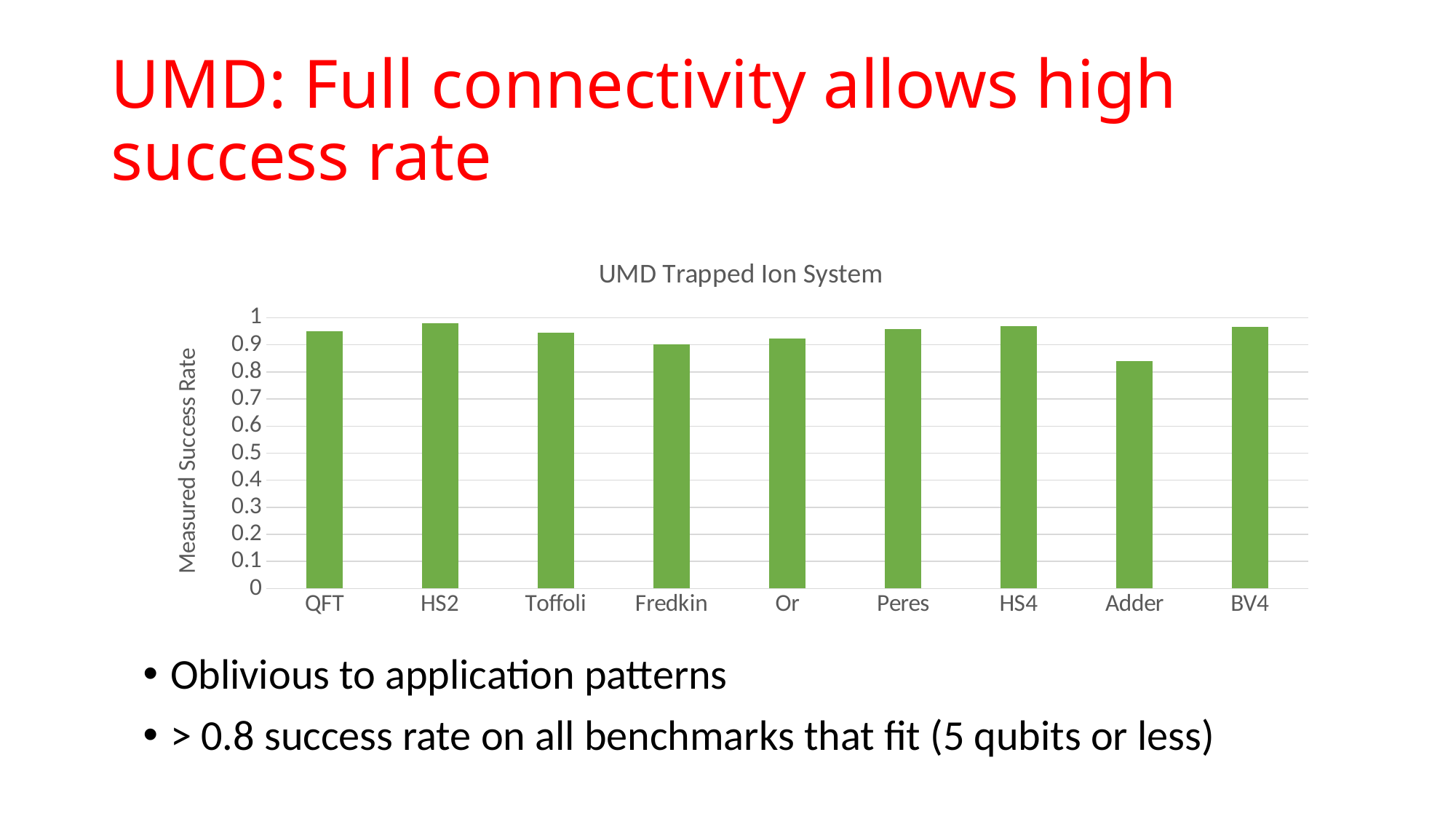
Is the value for Toffoli greater or less than 0.9? greater Which has the higher measured success rate, BV4 or Adder? BV4 Is the value for HS2 greater or less than 0.9? greater Which has the higher measured success rate, HS2 or Adder? HS2 How many benchmarks are plotted on the chart? 9 What is the label of the vertical axis? Measured Success Rate Which has the higher measured success rate, Peres or Fredkin? Peres Which benchmark has the lowest measured success rate? Adder Is the value for Adder greater or less than 0.8? greater What kind of chart is shown on the slide? bar chart What is the title of the chart? UMD Trapped Ion System